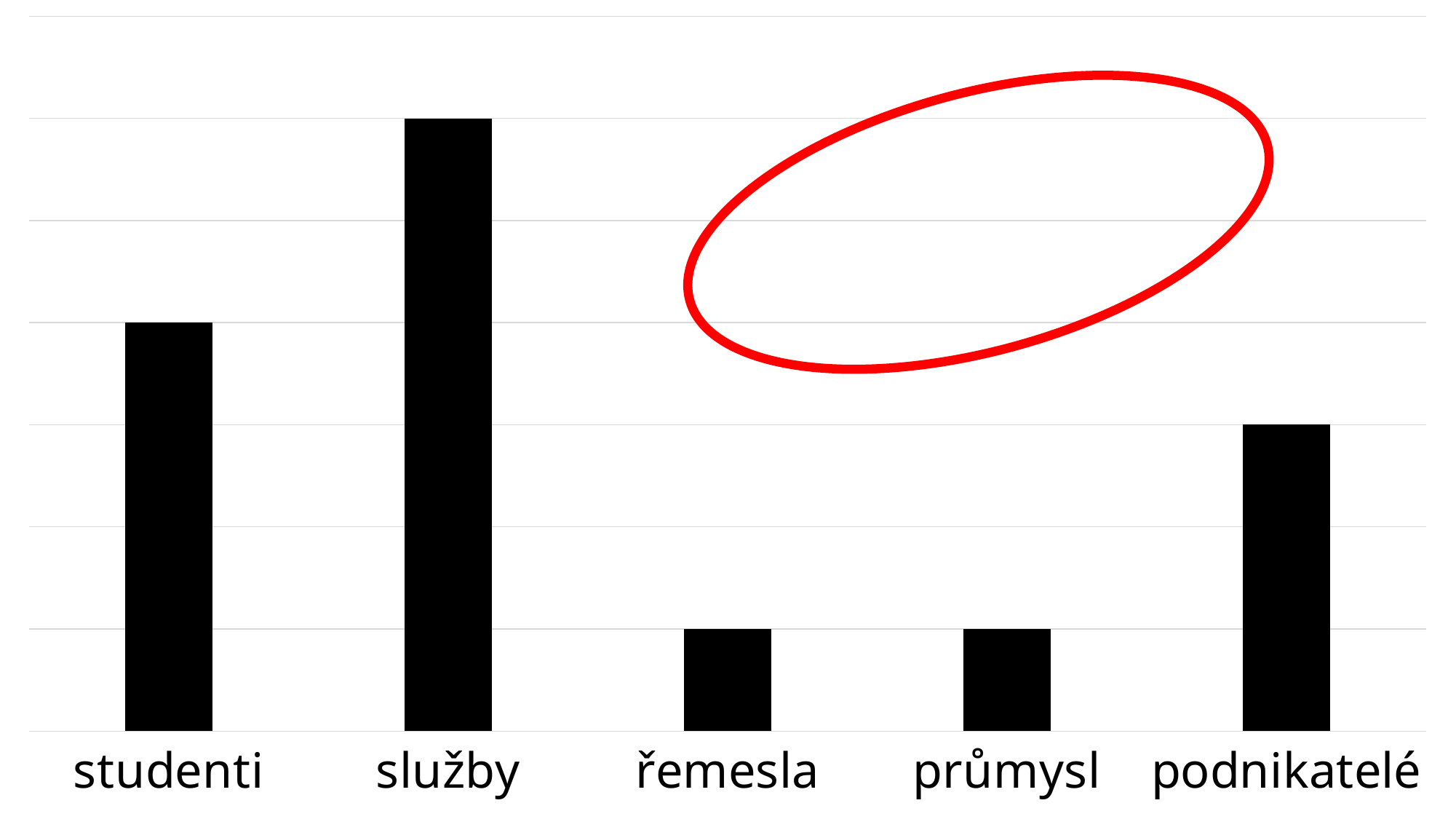
Which category is the first one on the x axis of the chart? studenti How many categories are shown on the x axis of the chart? 5 Which is larger, the value for služby or the value for studenti? služby What colour are the bars in the chart? black Which category has the highest bar in the chart? služby Which is larger, the value for podnikatelé or the value for průmysl? podnikatelé What kind of chart is shown on the slide? bar chart Which is larger, the value for studenti or the value for podnikatelé? studenti